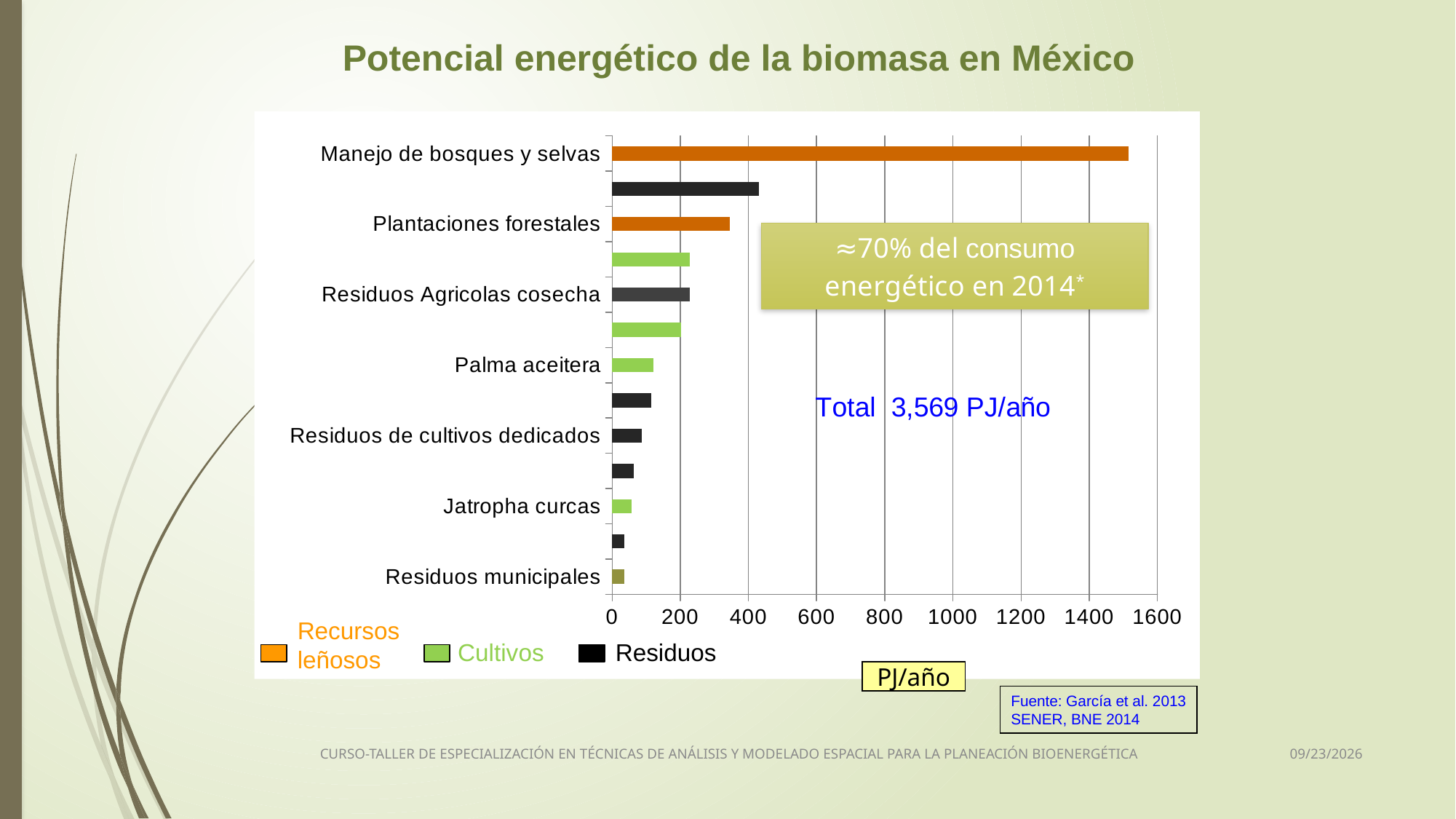
What kind of chart is shown on the slide? bar chart Which is larger, the value for Palma aceitera or the value for Jatropha curcas? Palma aceitera Is the value for Plantaciones forestales greater or less than 400? less Among the labeled categories, which has the lowest value? Residuos municipales Which is larger, the value for Plantaciones forestales or the value for Residuos Agricolas cosecha? Plantaciones forestales Is the value for Palma aceitera greater or less than 200? less What total is stated on the chart? 3,569 PJ/año How many entries does the legend list? 3 Is the value for Jatropha curcas greater or less than 200? less Which category has the highest value in the chart? Manejo de bosques y selvas